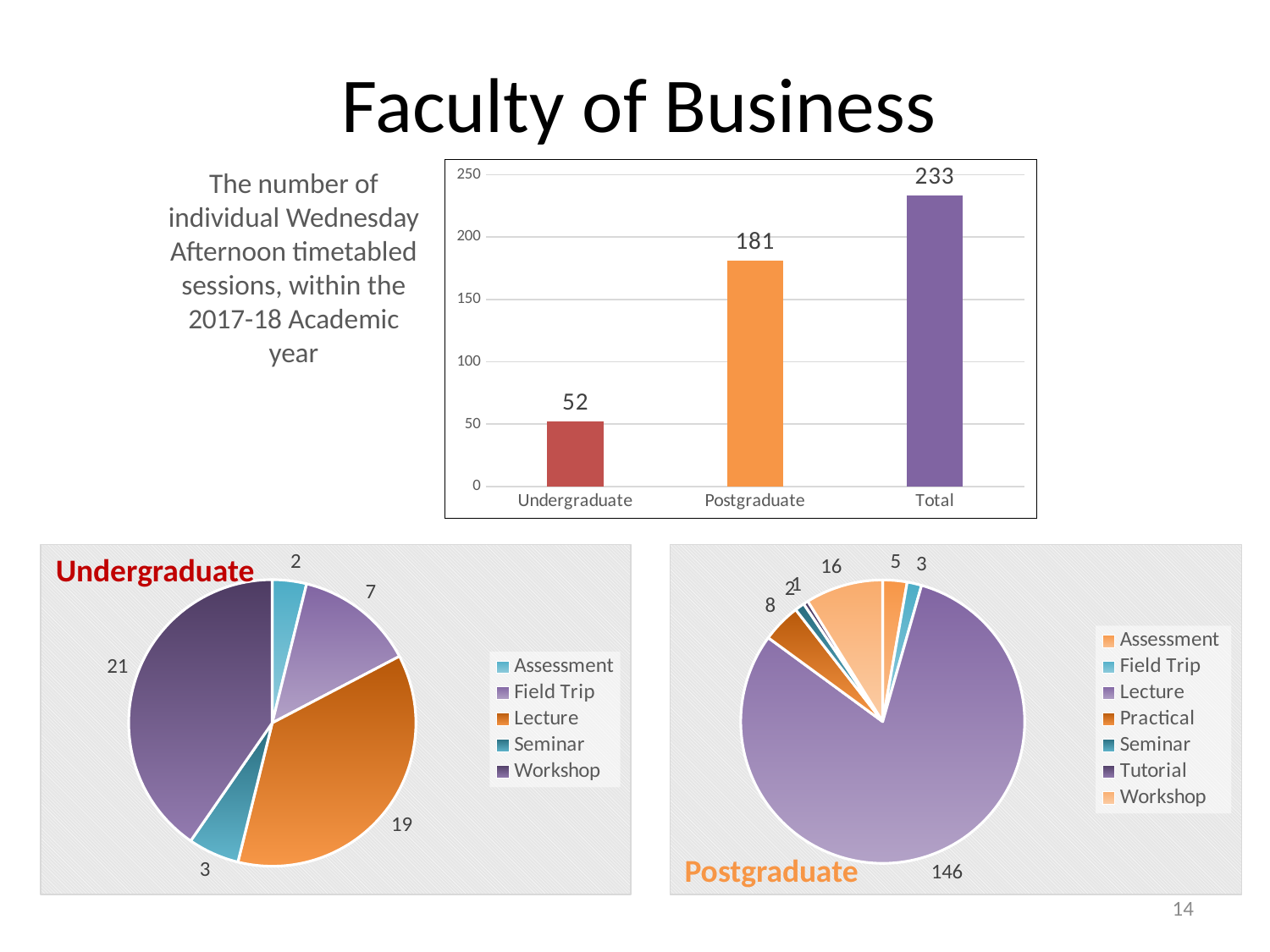
In the Undergraduate pie chart, which session type has the largest slice? Workshop In the bar chart at the top of the slide, what is the difference between the Total and Postgraduate values? 52 In the Postgraduate pie chart, how many session types does the legend list? 7 In the Undergraduate pie chart, how many sessions are Lectures? 19 In the Postgraduate pie chart, how many sessions are Workshops? 16 In the Undergraduate pie chart, how many session types does the legend list? 5 In the Postgraduate pie chart, how many sessions are Lectures? 146 In the bar chart at the top of the slide, what is the value for Postgraduate? 181 In the bar chart at the top of the slide, what is the value for Undergraduate? 52 In the bar chart at the top of the slide, which category has the lowest value? Undergraduate What kind of chart is the chart at the top of the slide? Bar chart In the Postgraduate pie chart, which is larger, Practical or Field Trip? Practical